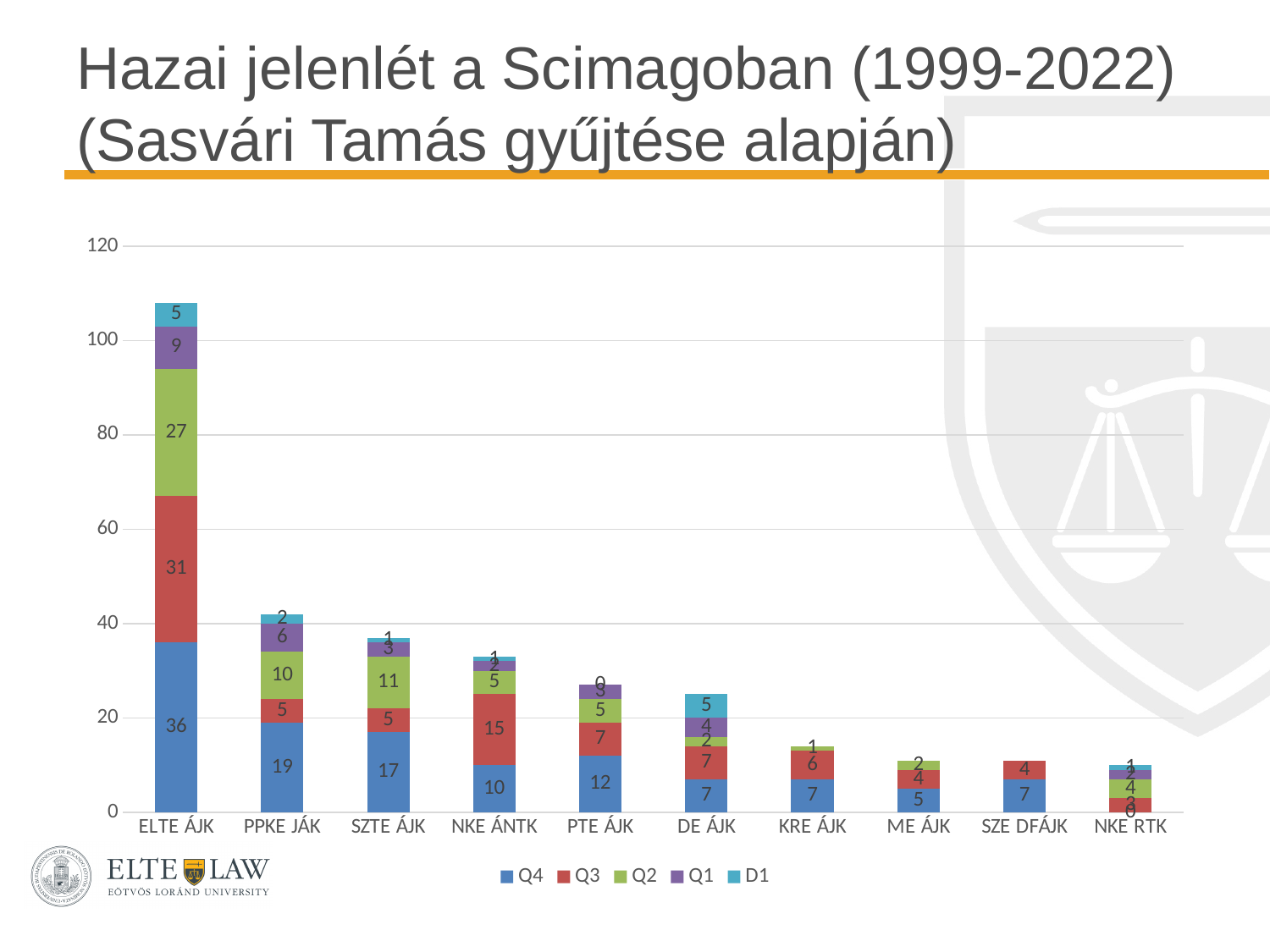
What is the total of the stacked bar for ELTE ÁJK? 108 Which is larger: the Q3 value for ELTE ÁJK or the Q4 value for PPKE JÁK? Q3 value for ELTE ÁJK What is the Q2 value for SZTE ÁJK? 11 How many series does the legend list? 5 What is the Q4 value for ELTE ÁJK? 36 Do the total bar heights rise or fall from left to right along the x axis? fall Which institution has the highest total bar? ELTE ÁJK What is the Q3 value for NKE ÁNTK? 15 Is the total bar for SZTE ÁJK greater or less than 40? less What is the difference between the Q4 and Q3 values for ELTE ÁJK? 5 How many institutions (categories) are shown on the x axis? 10 What kind of chart is shown on the slide? stacked bar chart